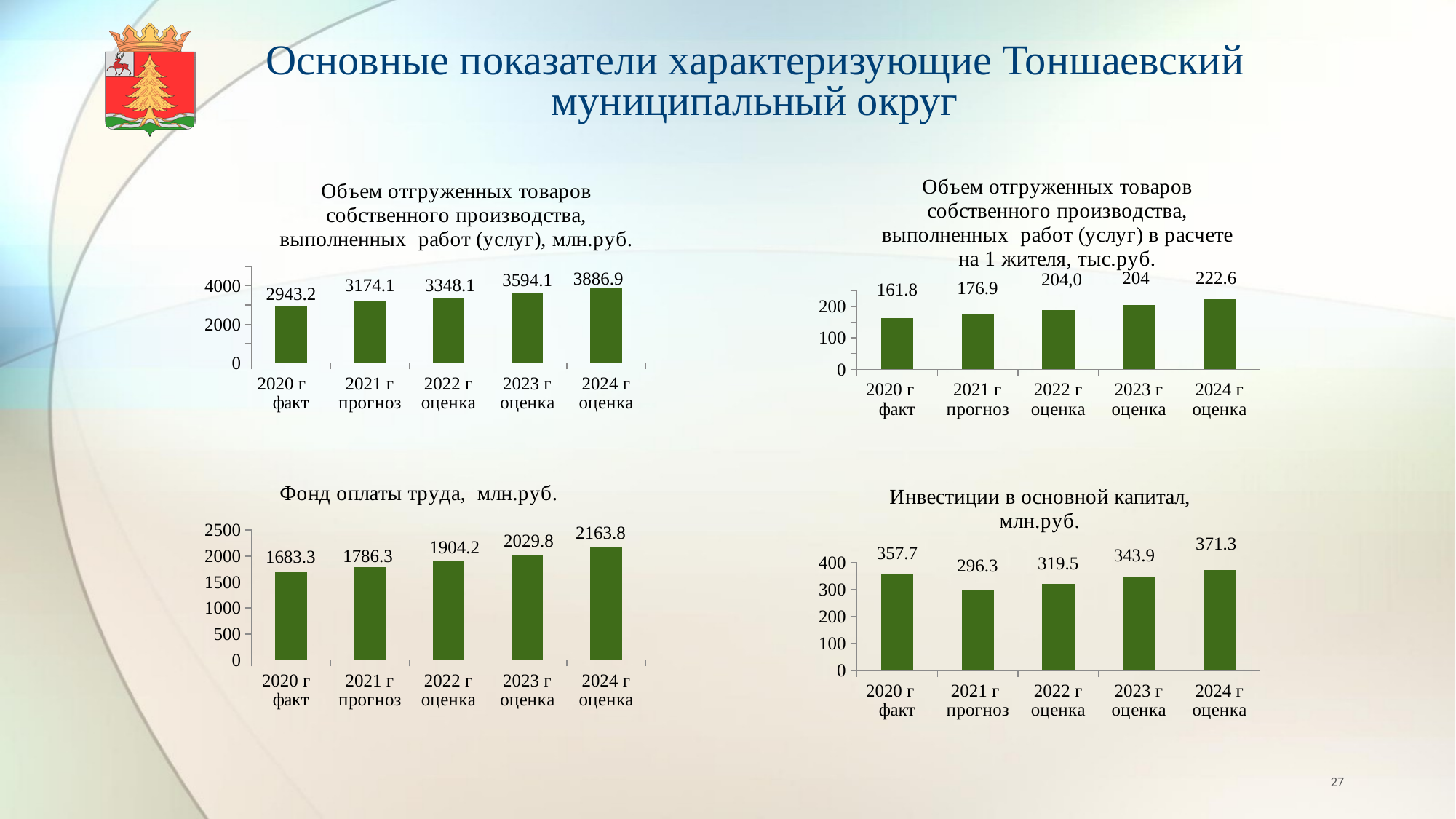
In the top-right chart (per 1 resident, тыс.руб.), what is the value for 2021 г прогноз? 176.9 In the top-right chart (per 1 resident, тыс.руб.), which year has the lowest value? 2020 г факт What type of chart is the bottom-right chart (Инвестиции в основной капитал)? bar chart In the bottom-right chart (Инвестиции в основной капитал), which is larger: the value for 2020 г факт or 2023 г оценка? 2020 г факт In the bottom-right chart (Инвестиции в основной капитал), which year has the lowest value? 2021 г прогноз In the top-left chart (Объем отгруженных товаров ... млн.руб.), what is the value for 2020 г факт? 2943.2 In the top-left chart (Объем отгруженных товаров ... млн.руб.), what is the difference between the 2024 г оценка and 2023 г оценка values? 292.8 In the bottom-left chart (Фонд оплаты труда), do the values rise or fall from 2020 to 2024? rise In the top-left chart (Объем отгруженных товаров ... млн.руб.), which year has the highest value? 2024 г оценка In the top-right chart (per 1 resident, тыс.руб.), is the value for 2024 г оценка greater or less than 200? greater In the bottom-left chart (Фонд оплаты труда), how many bars are plotted? 5 In the bottom-left chart (Фонд оплаты труда), what is the value for 2022 г оценка? 1904.2